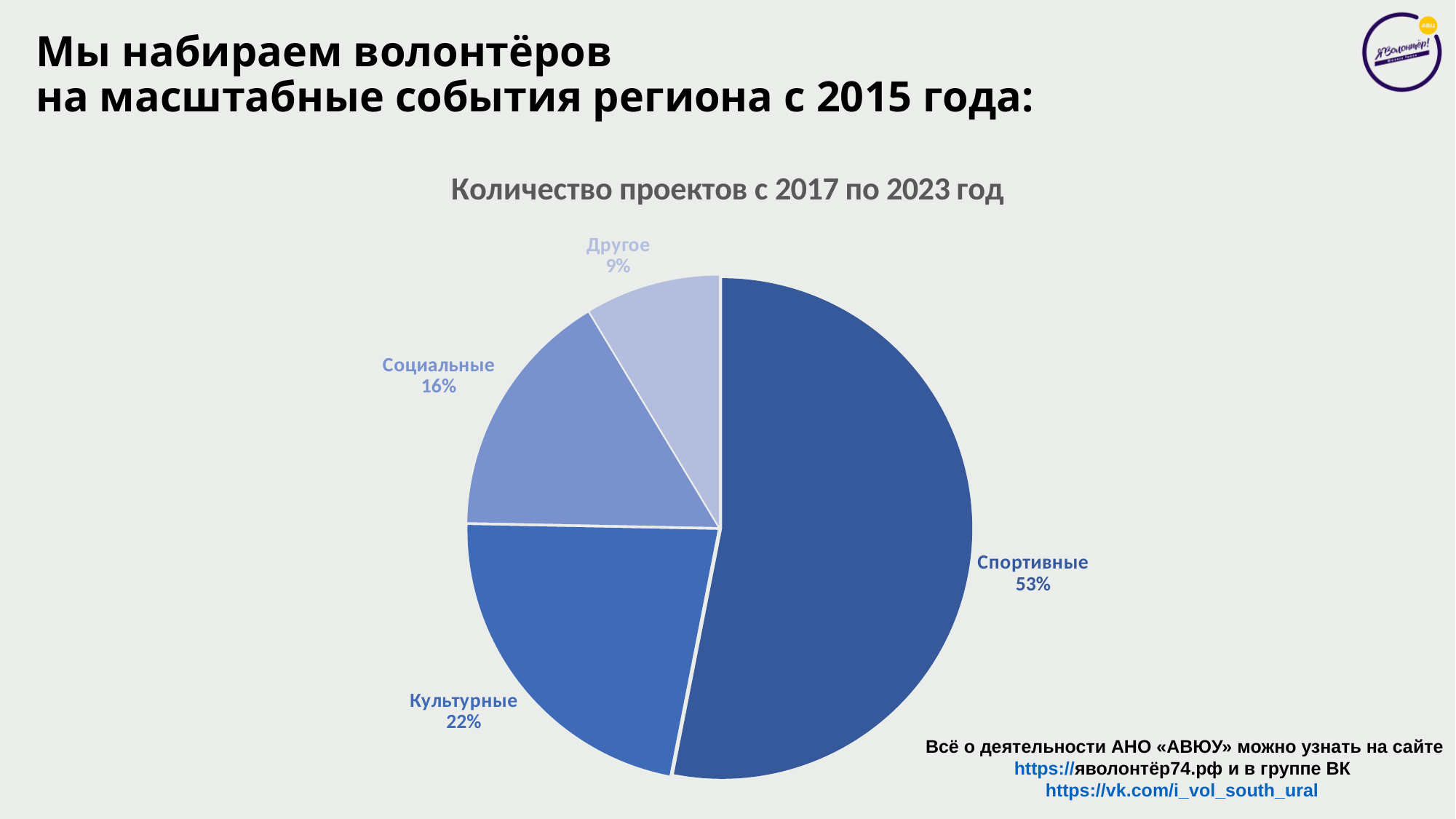
What kind of chart is shown on the slide? pie chart Which is larger, Социальные or Другое? Социальные What is the difference in percentage points between Спортивные and Культурные? 31 What is the title of the chart? Количество проектов с 2017 по 2023 год What is the difference in percentage points between Социальные and Другое? 7 What share of the pie does Социальные take? 16% What share of the pie does Спортивные take? 53% What share of the pie does Культурные take? 22% How many slices does the pie chart have? 4 What share of the pie does Другое take? 9% Which category has the largest slice? Спортивные Which category has the smallest slice? Другое